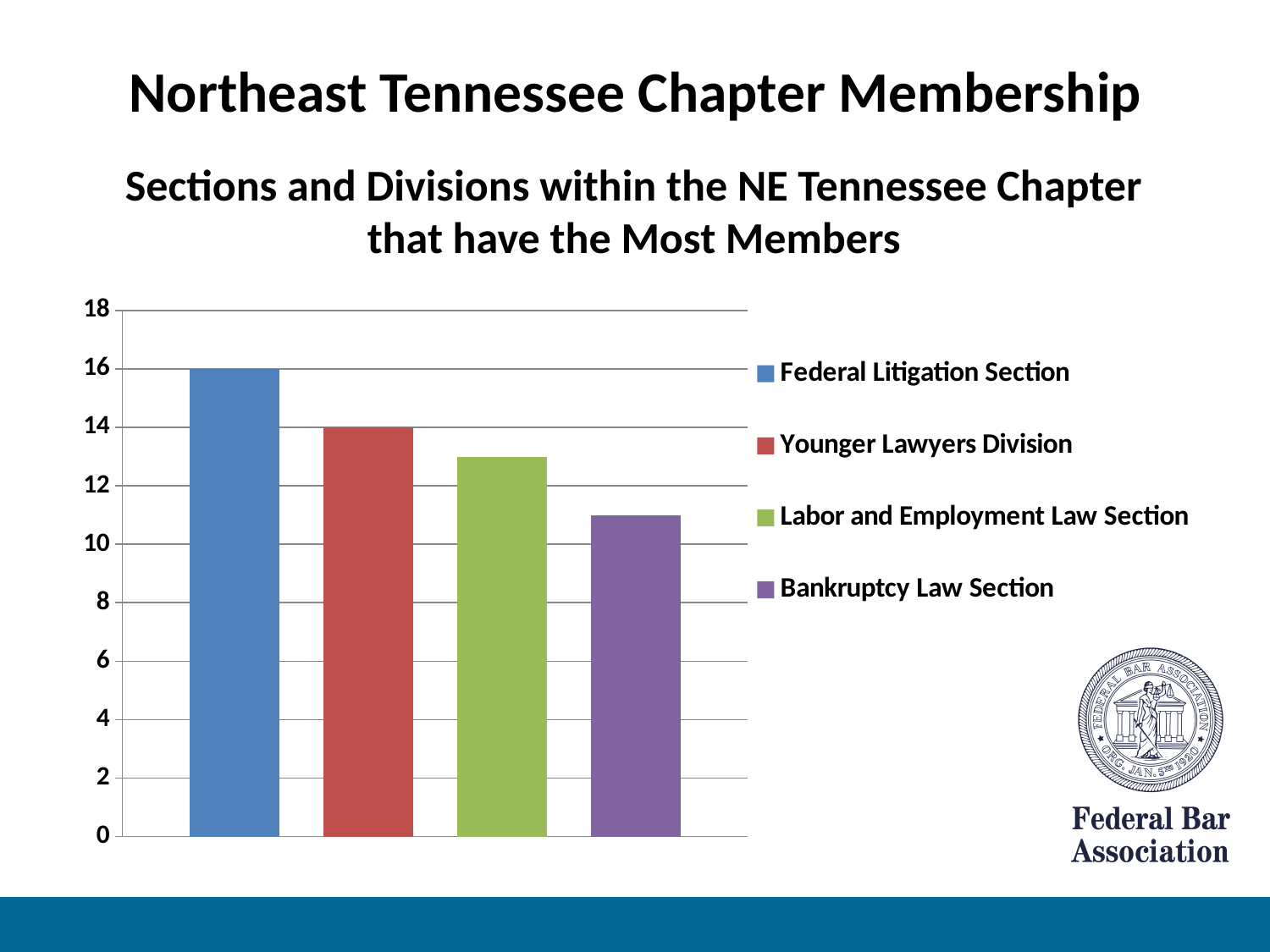
What is the value for the Younger Lawyers Division? 14 Which is larger, the value for the Labor and Employment Law Section or the Bankruptcy Law Section? Labor and Employment Law Section Do the bar values rise or fall from left to right across the chart? Fall Is the value for the Labor and Employment Law Section greater or less than 12? greater What is the value for the Federal Litigation Section? 16 What kind of chart is shown on the slide? Bar chart Is the value for the Bankruptcy Law Section greater or less than 12? less Which section or division has the highest value? Federal Litigation Section What is the difference between the Federal Litigation Section and the Younger Lawyers Division? 2 How many bars are plotted in the chart? 4 How many entries does the legend list? 4 Which section or division has the lowest value? Bankruptcy Law Section